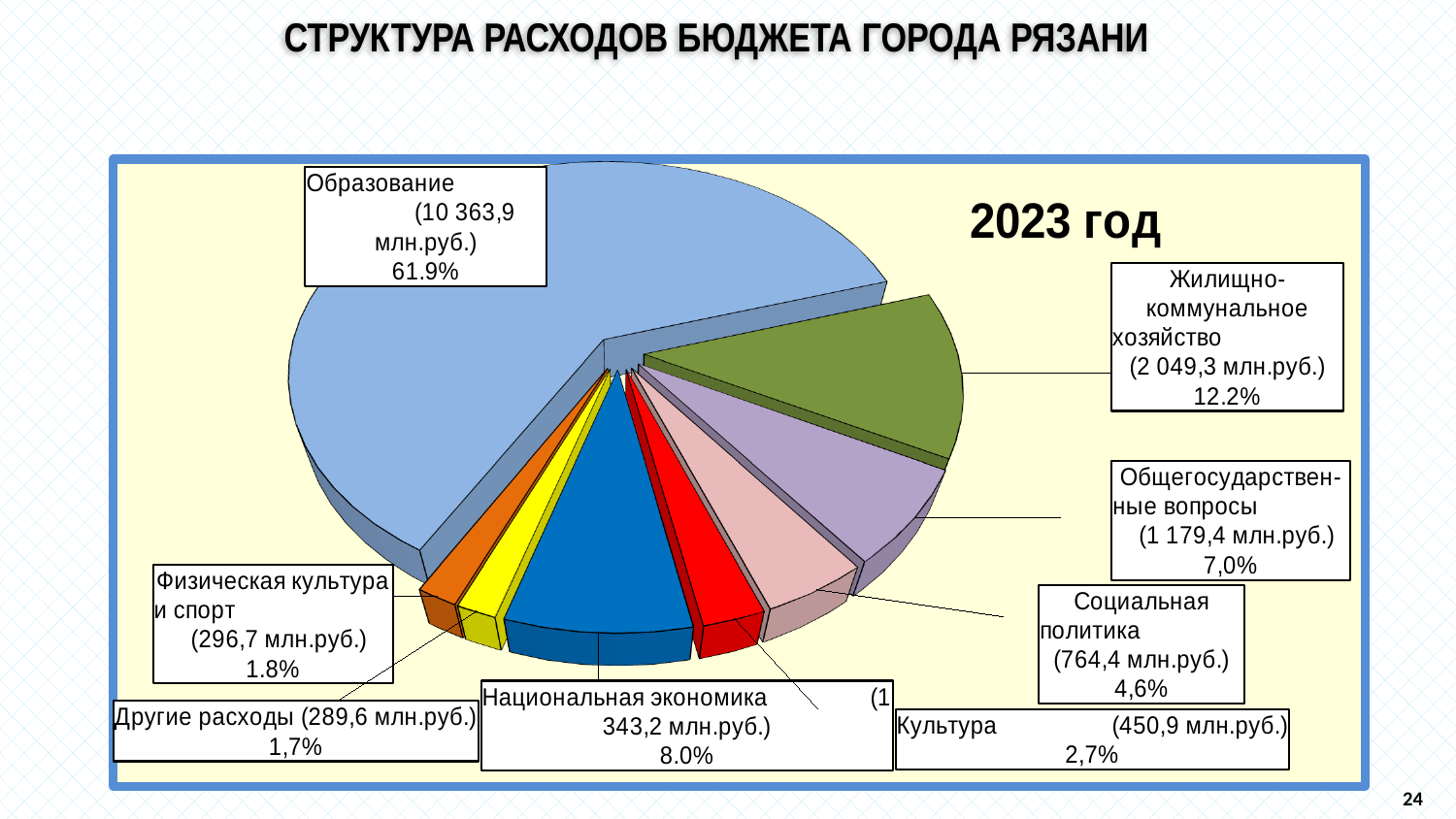
What is the value for Физическая культура и спорт? 296,7 млн.руб. What share of the budget expenditure does Образование account for? 61.9% What is the value for Жилищно-коммунальное хозяйство in млн.руб.? 2 049,3 млн.руб. What percentage share does Общегосударственные вопросы have? 7,0% Which year does the chart refer to? 2023 год What percentage share does Другие расходы have? 1,7% What is the value for Социальная политика? 764,4 млн.руб. How many categories are shown in the pie chart? 8 Which category has the smallest share of the pie? Другие расходы Which category has the largest share of the pie? Образование What type of chart is shown on the slide? pie chart